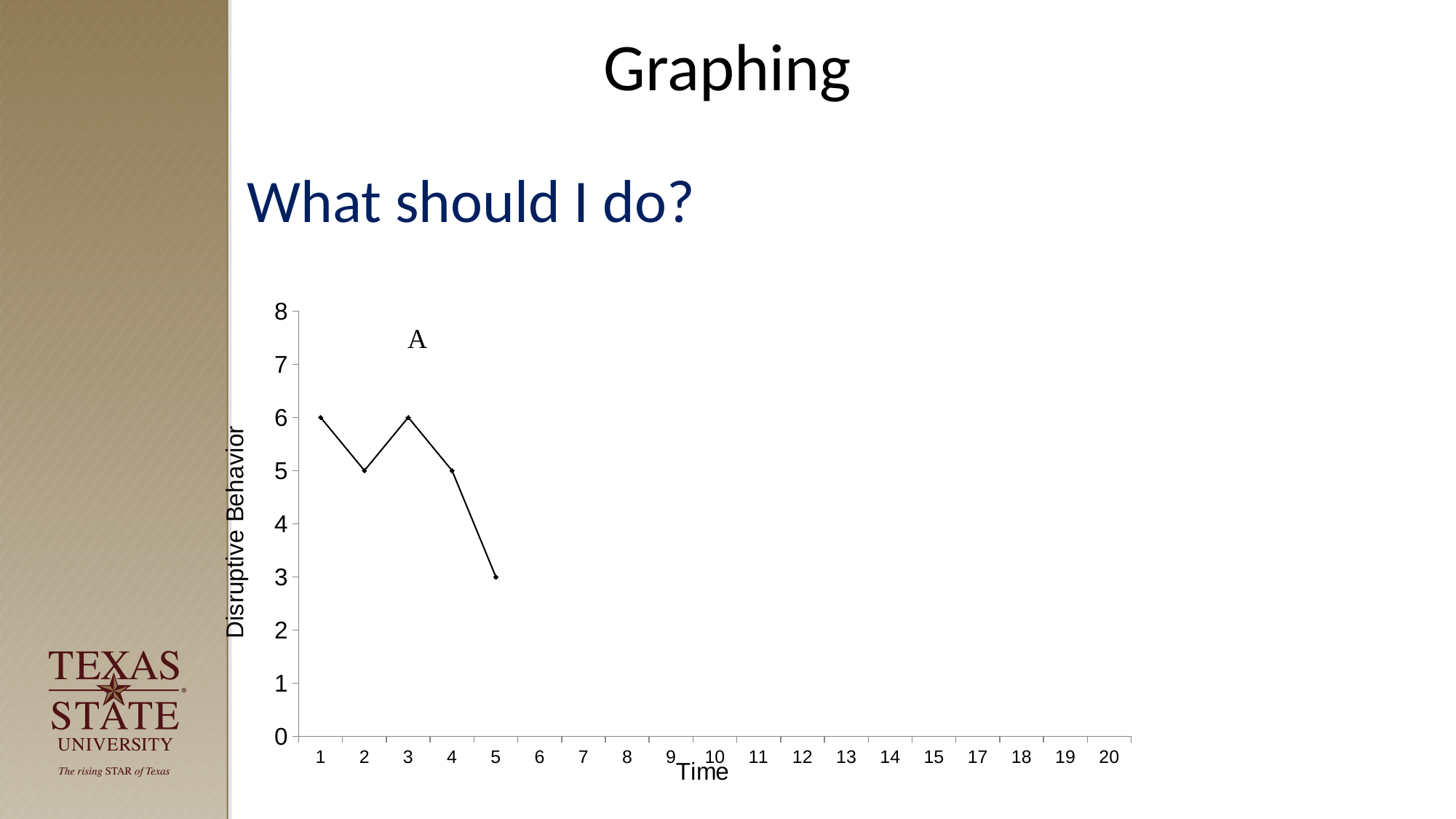
What is the value of Disruptive Behavior at Time 1? 6 What is the value of Disruptive Behavior at Time 5? 3 Which is larger, the Disruptive Behavior value at Time 4 or at Time 5? Time 4 At which Time point is Disruptive Behavior lowest? 5 What is the difference in Disruptive Behavior between Time 3 and Time 5? 3 What letter labels the phase shown above the plotted data? A How many data points are plotted on the chart? 5 Overall, do the Disruptive Behavior values rise or fall from Time 1 to Time 5? fall What is the label on the y-axis of the chart? Disruptive Behavior What is the value of Disruptive Behavior at Time 2? 5 What kind of chart is shown on the slide? line chart Is the value of Disruptive Behavior at Time 5 greater or less than 4? less